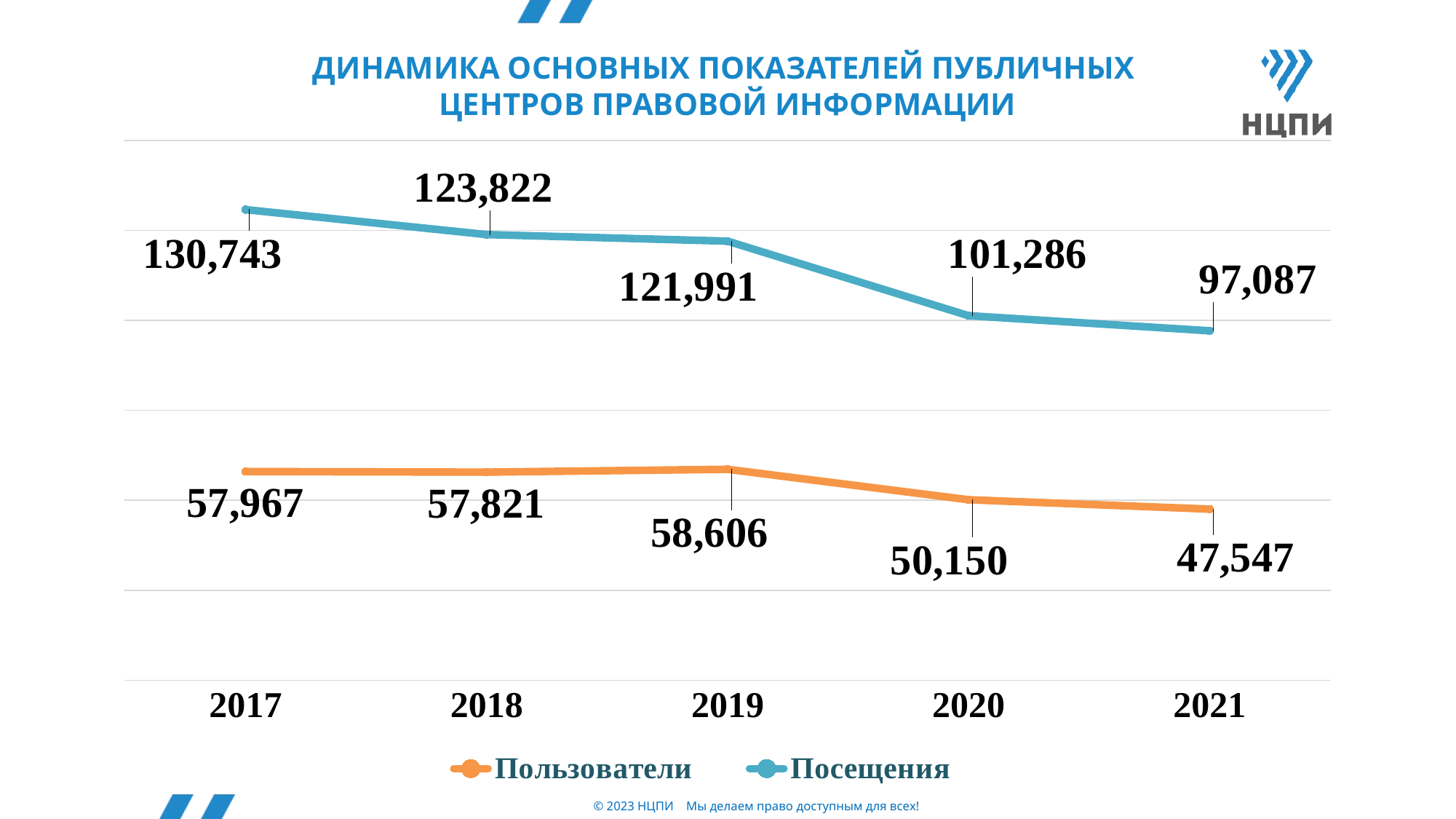
Which is larger: Посещения in 2020 or Посещения in 2021? Посещения in 2020 What is the value of Посещения in 2017? 130,743 What is the value of Посещения in 2019? 121,991 How many series does the legend list? 2 What is the difference between Посещения in 2017 and in 2021? 33,656 How many years are shown on the x axis? 5 In which year is Пользователи highest? 2019 Does Посещения rise or fall from 2017 to 2021? fall What is the value of Пользователи in 2020? 50,150 In which year is Посещения lowest? 2021 What type of chart is shown on the slide? line chart What is the difference between Пользователи in 2019 and in 2020? 8,456